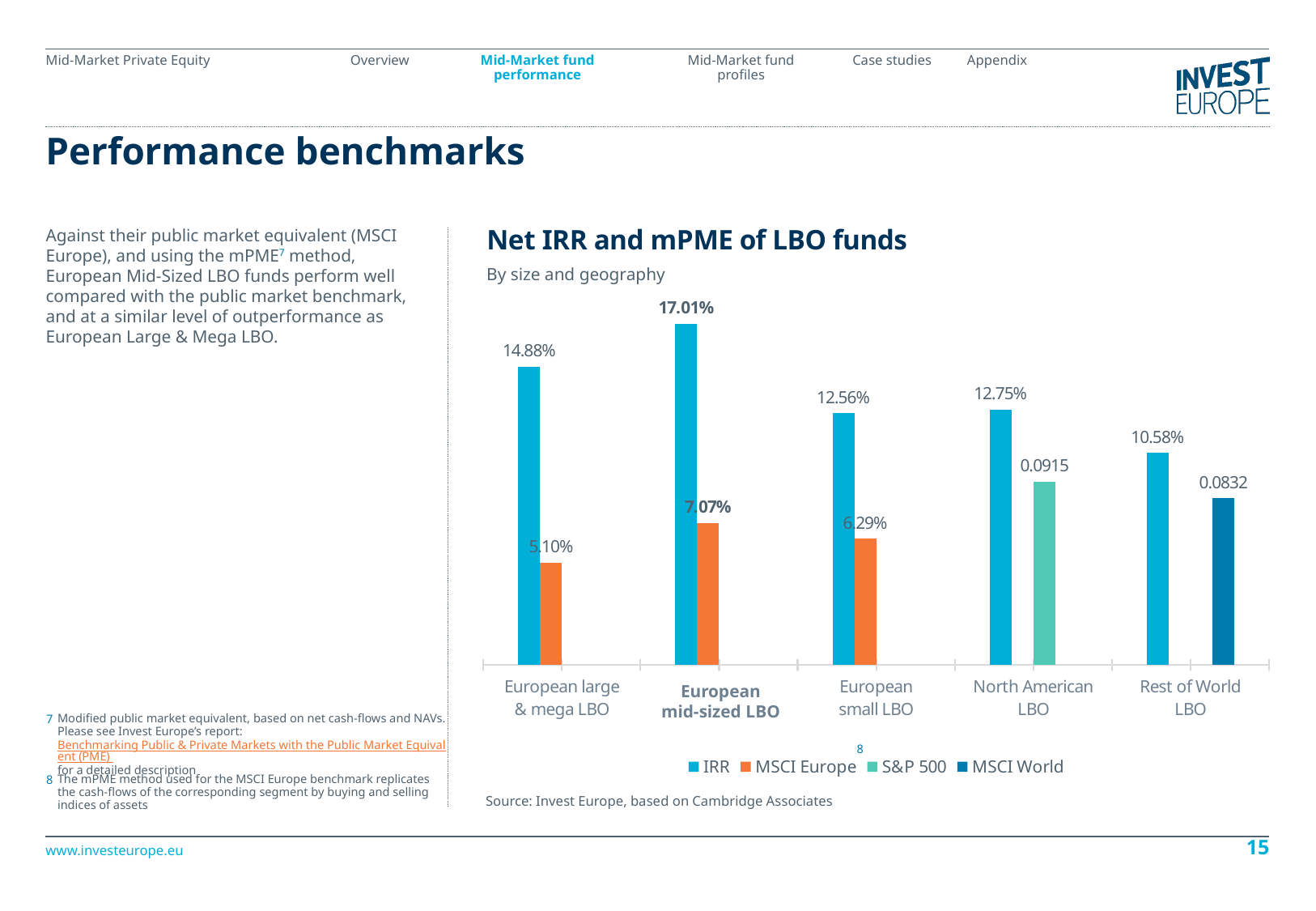
Which is larger, the IRR for European large & mega LBO or the IRR for European small LBO? European large & mega LBO How many categories are shown on the x axis? 5 What is the S&P 500 value shown for North American LBO? 0.0915 What is the IRR for European mid-sized LBO? 17.01% Which category has the lowest IRR? Rest of World LBO How many series does the legend list? 4 What is the difference between the IRR and the MSCI Europe value for European mid-sized LBO? 9.94% Which category has the highest IRR? European mid-sized LBO What is the subtitle of the chart? By size and geography What is the MSCI Europe mPME value for European large & mega LBO? 5.10% What kind of chart is shown? Bar chart What is the MSCI World value shown for Rest of World LBO? 0.0832